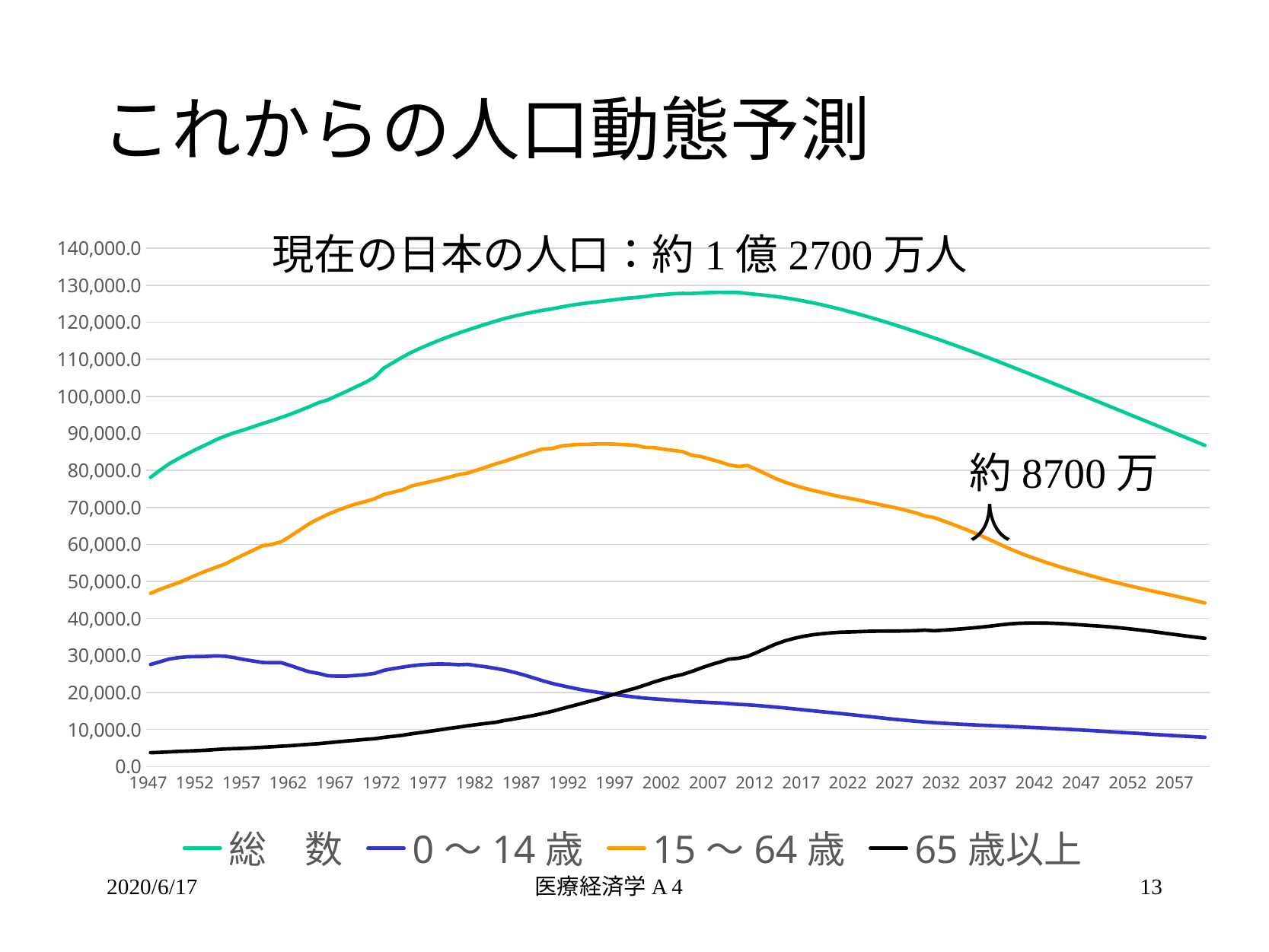
What are the four series listed in the legend? 総数, 0～14歳, 15～64歳, 65歳以上 How many series does the legend list? 4 Is the peak value of 総数 (around 2007) greater or less than 120,000.0? greater Does the 0～14歳 line rise or fall from 1982 to 2057? fall Does the 65歳以上 line rise or fall from 1947 to 2042? rise Is the value for 65歳以上 in 1947 greater or less than 10,000.0? less Which series has the lowest value in 2057? 0～14歳 In 1947, which is larger: 0～14歳 or 65歳以上? 0～14歳 What kind of chart is shown on the slide? line chart Is the value for 15～64歳 in 2057 greater or less than 50,000.0? less In 2057, which is larger: 65歳以上 or 0～14歳? 65歳以上